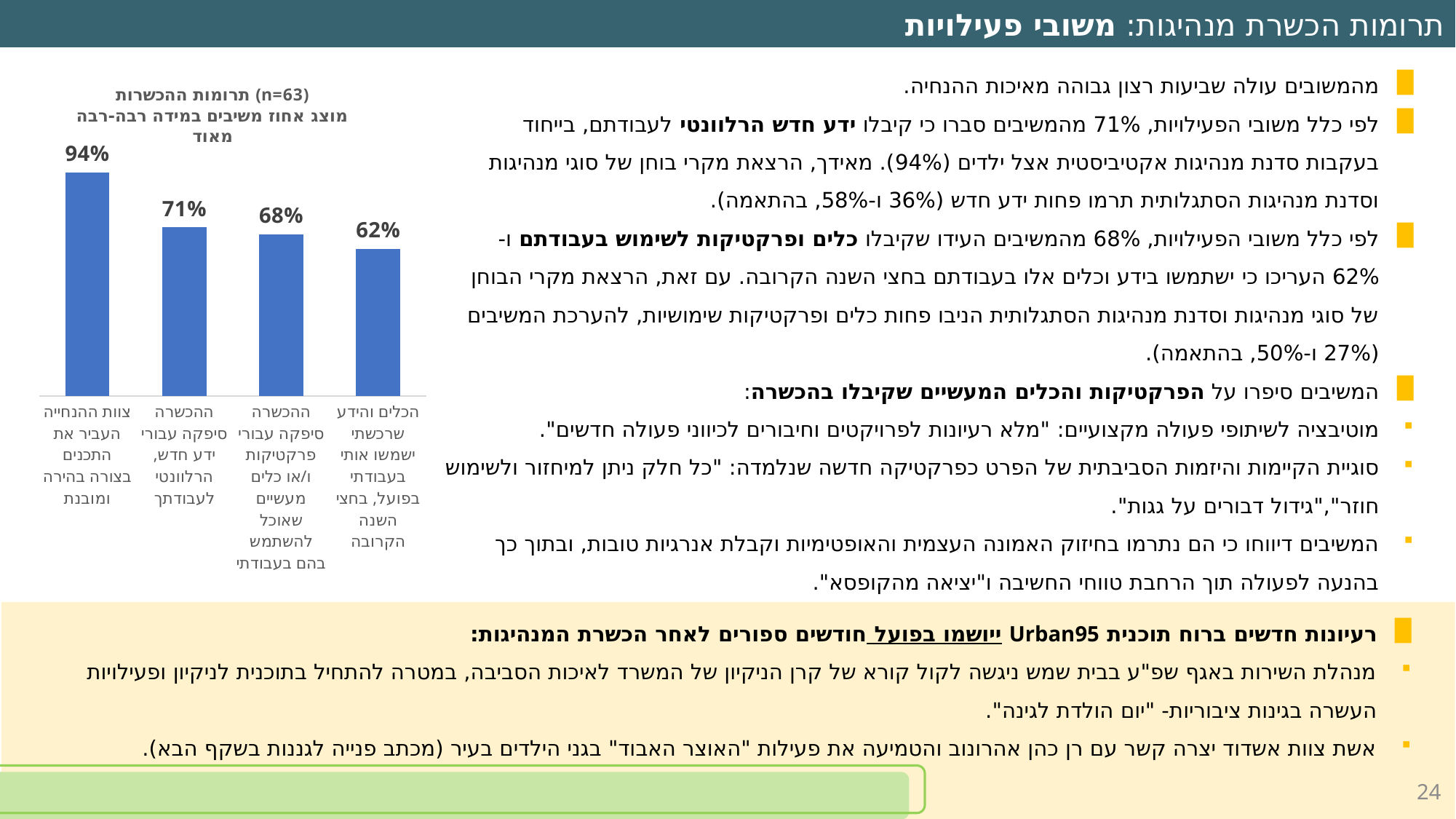
Do the bar values rise or fall from left to right across the chart? fall How many bars (categories) does the chart show? 4 What is the value for the category "ההכשרה סיפקה עבורי ידע חדש, הרלוונטי לעבודתך"? 71% What is the value for the category "צוות ההנחייה העביר את התכנים בצורה בהירה ומובנת"? 94% Which category has the highest value in the chart? צוות ההנחייה העביר את התכנים בצורה בהירה ומובנת Which category has the lowest value in the chart? הכלים והידע שרכשתי ישמשו אותי בעבודתי בפועל, בחצי השנה הקרובה What is the value for the category "ההכשרה סיפקה עבורי פרקטיקות ו/או כלים מעשיים שאוכל להשתמש בהם בעבודתי"? 68% Which is larger: the value for "ההכשרה סיפקה עבורי ידע חדש, הרלוונטי לעבודתך" or the value for "ההכשרה סיפקה עבורי פרקטיקות ו/או כלים מעשיים שאוכל להשתמש בהם בעבודתי"? ההכשרה סיפקה עבורי ידע חדש, הרלוונטי לעבודתך What sample size (n) is stated in the chart title? n=63 What type of chart is shown on the slide? bar chart What is the difference between the highest bar (94%) and the lowest bar (62%)? 32% What is the value for the category "הכלים והידע שרכשתי ישמשו אותי בעבודתי בפועל, בחצי השנה הקרובה"? 62%